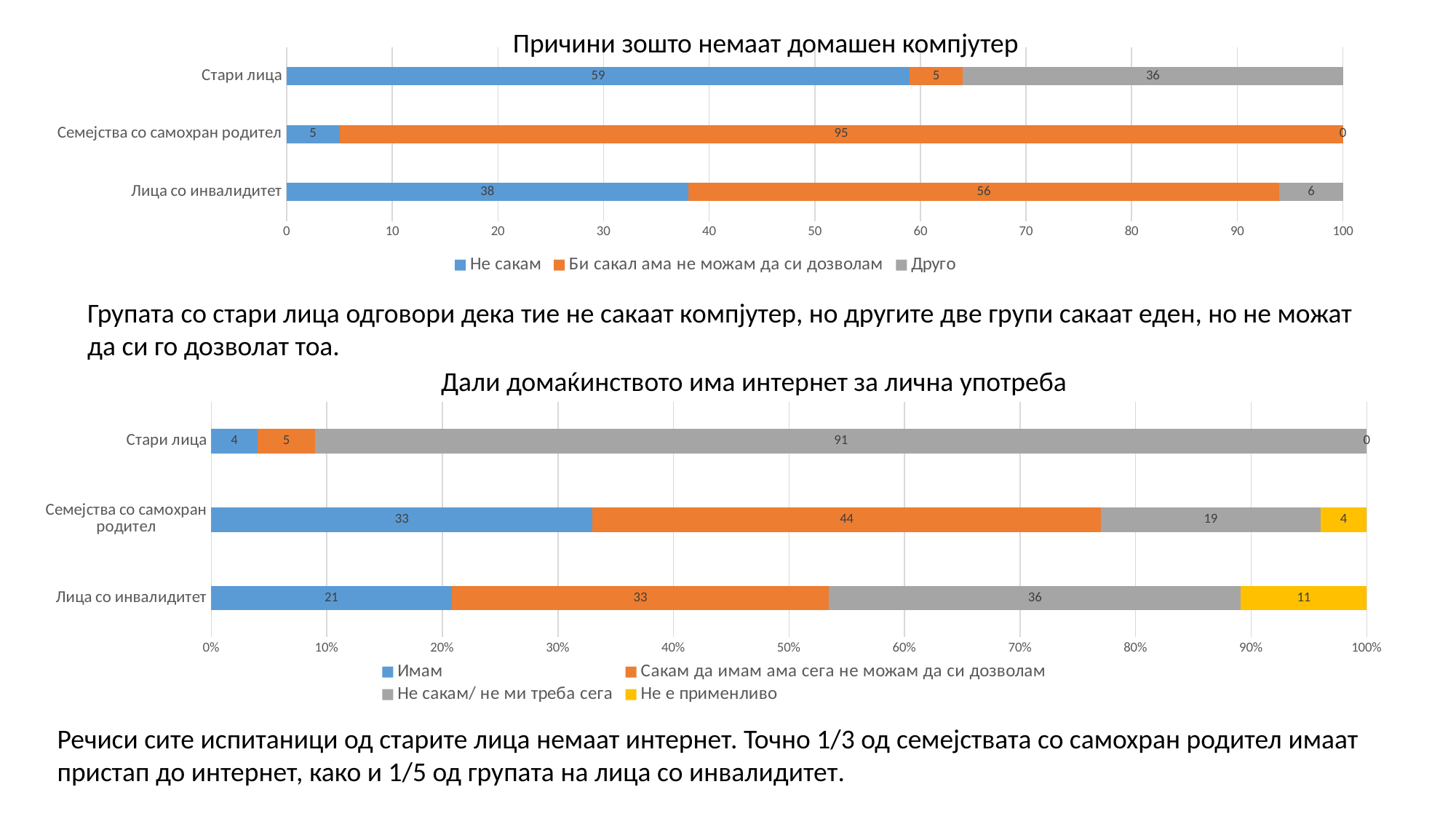
In the chart 'Причини зошто немаат домашен компјутер', what is the difference between the 'Би сакал ама не можам да си дозволам' value and the 'Не сакам' value for 'Лица со инвалидитет'? 18 In the chart 'Причини зошто немаат домашен компјутер', which category has the highest value for 'Не сакам'? Стари лица In the chart 'Причини зошто немаат домашен компјутер', what is the total of the stacked bar for 'Стари лица'? 100 In the chart 'Дали домаќинството има интернет за лична употреба', how many categories are shown on the vertical axis? 3 What type of chart is 'Дали домаќинството има интернет за лична употреба'? Stacked bar chart In the chart 'Дали домаќинството има интернет за лична употреба', what is the value of 'Имам' for 'Семејства со самохран родител'? 33 In the chart 'Причини зошто немаат домашен компјутер', what is the value of 'Не сакам' for 'Стари лица'? 59 In the chart 'Дали домаќинството има интернет за лична употреба', which is larger for 'Лица со инвалидитет': 'Сакам да имам ама сега не можам да си дозволам' or 'Не сакам/ не ми треба сега'? Не сакам/ не ми треба сега In the chart 'Дали домаќинството има интернет за лична употреба', what is the value of 'Не е применливо' for 'Лица со инвалидитет'? 11 In the chart 'Причини зошто немаат домашен компјутер', how many series does the legend list? 3 In the chart 'Дали домаќинството има интернет за лична употреба', which category has the lowest value for 'Имам'? Стари лица In the chart 'Причини зошто немаат домашен компјутер', what is the value of 'Би сакал ама не можам да си дозволам' for 'Семејства со самохран родител'? 95